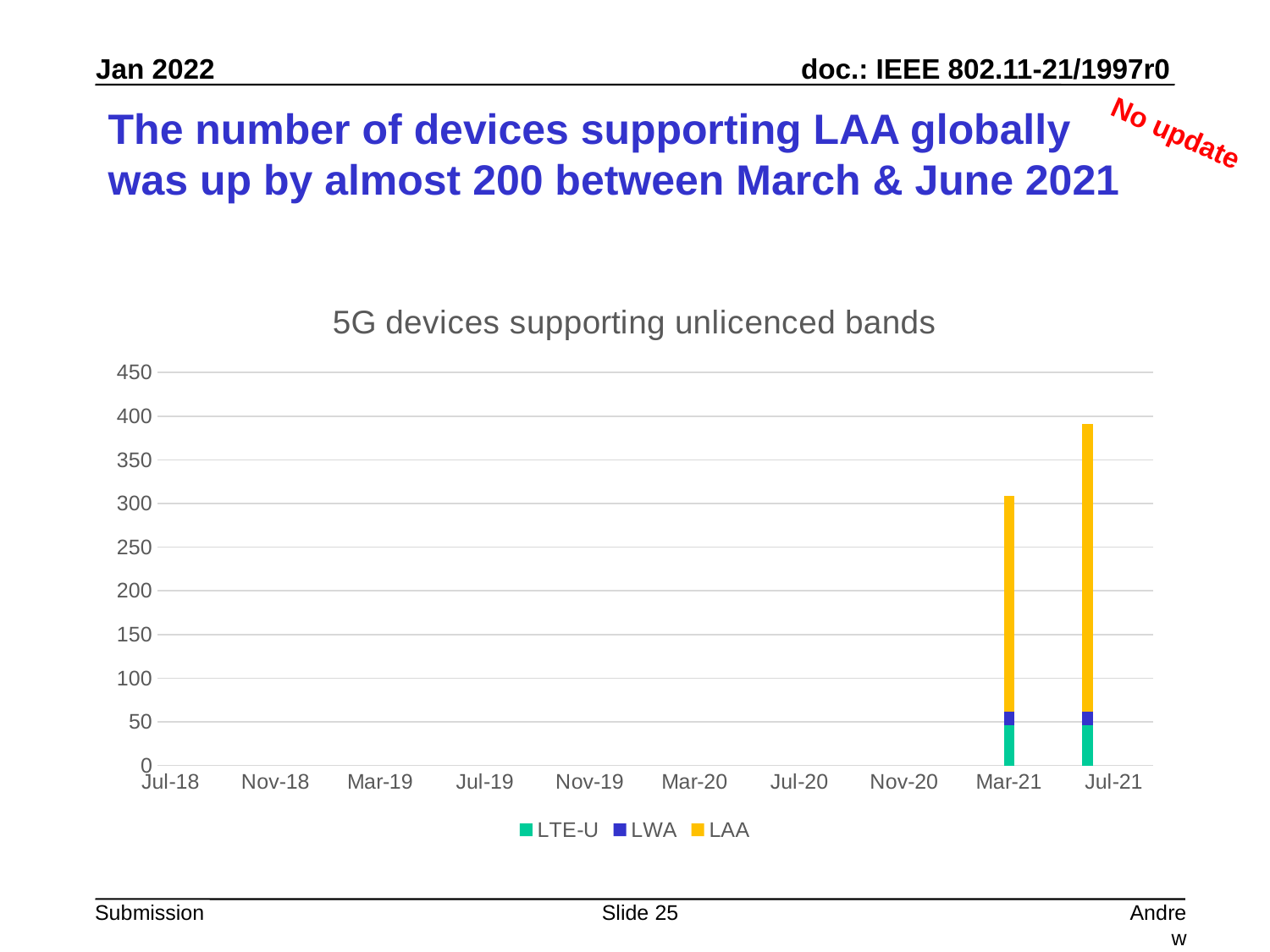
Which bar has the larger total, Mar-21 or Jul-21? Jul-21 Is the total of the Mar-21 bar greater or less than 350? less Which series are listed in the chart's legend? LTE-U, LWA, LAA What kind of chart is shown on the slide? stacked bar chart Is the total of the Jul-21 bar greater or less than 350? greater How many stacked bars are plotted in the chart? 2 How many date labels are shown along the x axis of the chart? 10 How many series does the chart's legend list? 3 What is the title of the chart? 5G devices supporting unlicenced bands Which bar has the highest total in the chart? Jul-21 Is the total of the Mar-21 bar greater or less than 250? greater Which series makes up the largest segment of each stacked bar? LAA